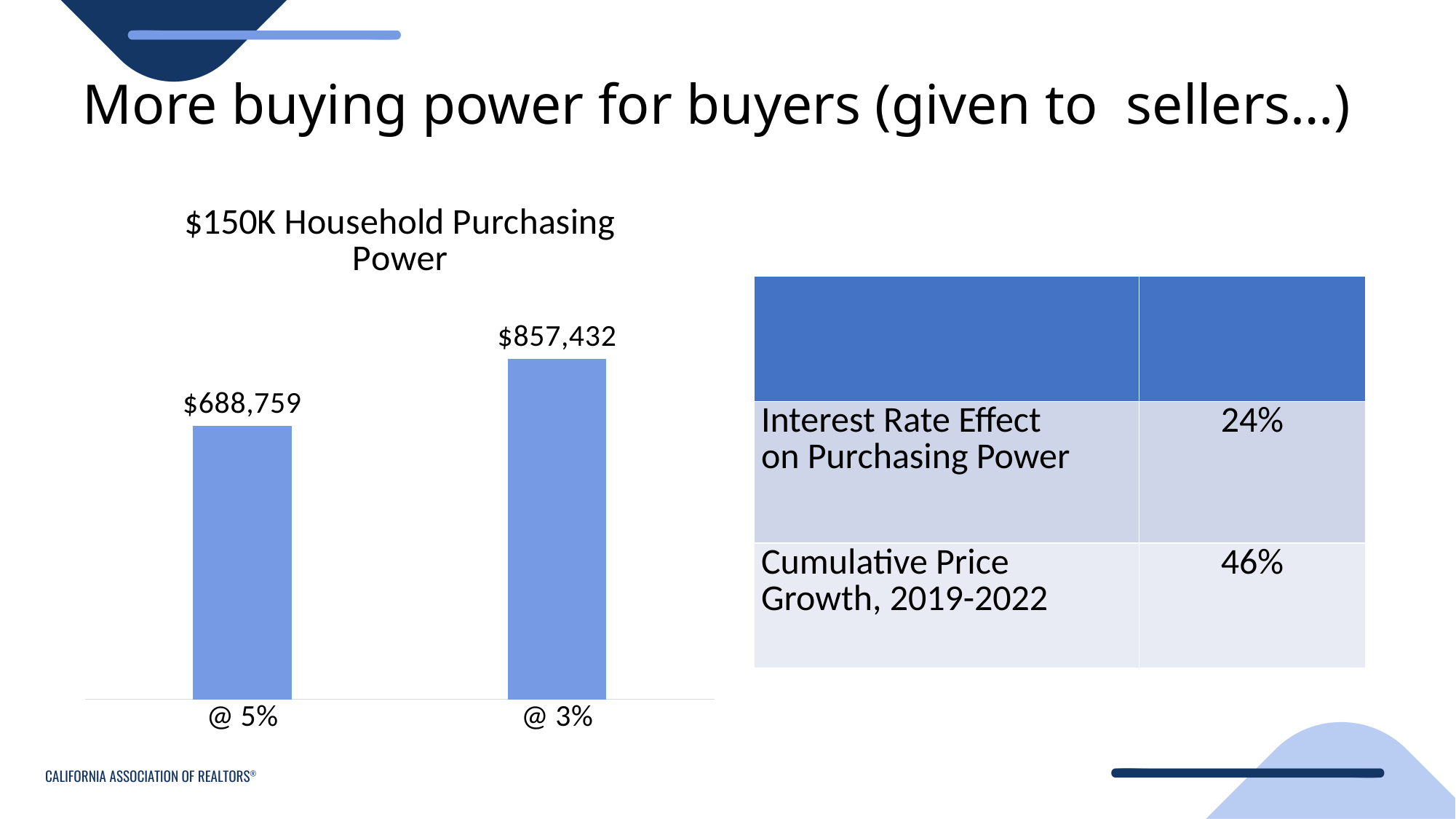
What is the title of the chart on the slide? $150K Household Purchasing Power How many bars are shown in the $150K Household Purchasing Power chart? 2 Is the value for @ 3% larger or smaller than the value for @ 5% in the $150K Household Purchasing Power chart? larger Which category has the lowest value in the $150K Household Purchasing Power chart? @ 5% Which category has the highest value in the $150K Household Purchasing Power chart? @ 3% Do the values rise or fall from left to right in the $150K Household Purchasing Power chart? rise What colour are the bars in the $150K Household Purchasing Power chart? blue What is the value for @ 5% in the $150K Household Purchasing Power chart? $688,759 What kind of chart is the $150K Household Purchasing Power chart? bar chart What is the difference between the @ 3% and @ 5% values in the $150K Household Purchasing Power chart? $168,673 What is the value for @ 3% in the $150K Household Purchasing Power chart? $857,432